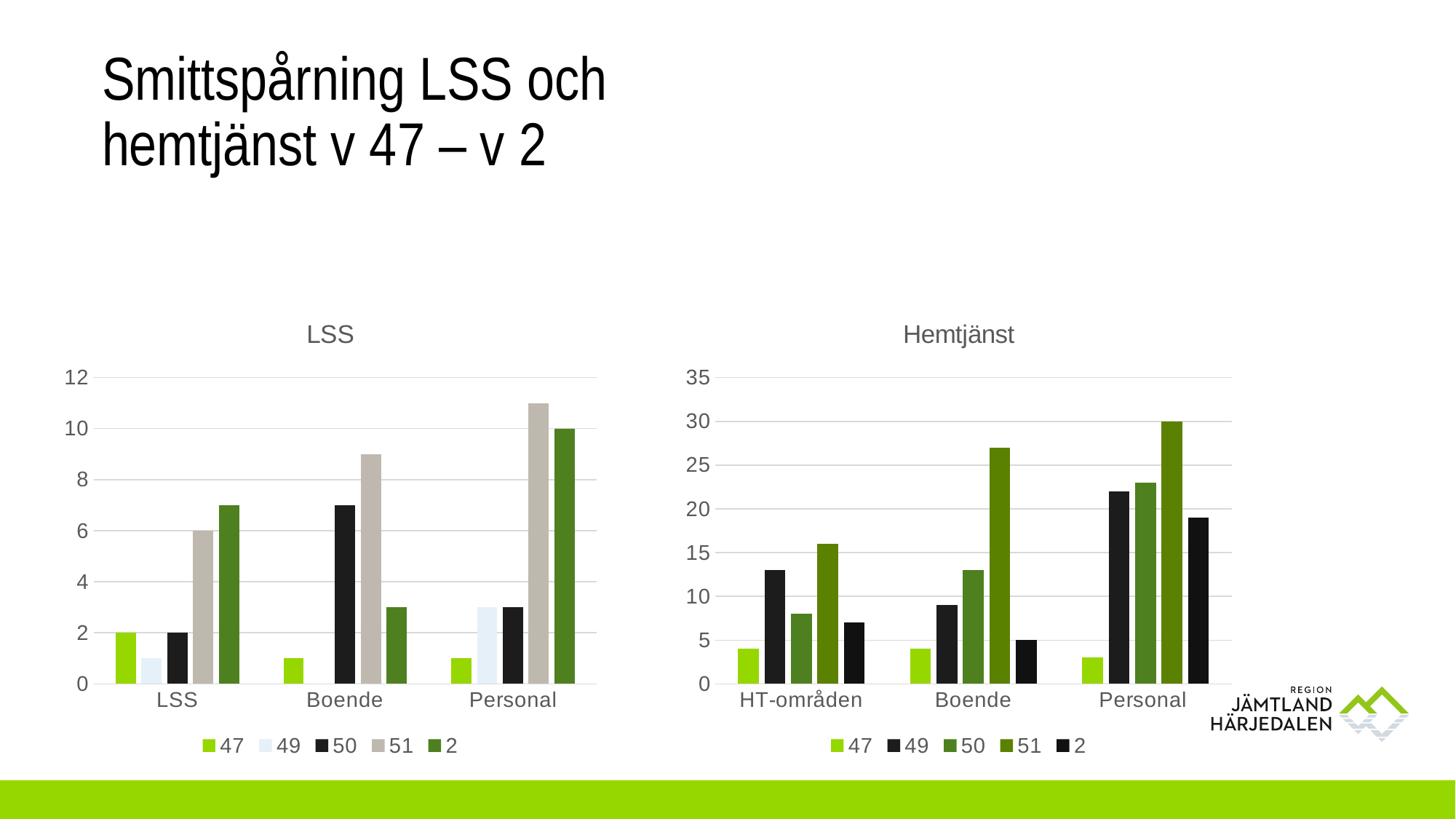
In the Hemtjänst chart, do the values for series 51 rise or fall from HT-områden to Personal? rise In the Hemtjänst chart, what is the value for series 51 in the Personal category? 30 In the Hemtjänst chart, what is the value for series 2 in the Boende category? 5 How many series does the legend of the Hemtjänst chart list? 5 In the LSS chart, which series has the highest bar in the Personal category? 51 In the Hemtjänst chart, which category and series has the highest bar? Personal, series 51 In the LSS chart, what is the value for series 51 in the LSS category? 6 In the LSS chart, in the Boende category, which is larger: series 51 or series 2? 51 In the LSS chart, is the value for series 51 in the Personal category greater or less than 10? greater In the LSS chart, what is the value for series 2 in the Personal category? 10 In the Hemtjänst chart, is the value for series 51 in the Boende category greater or less than 25? greater In the LSS chart, what is the value for series 47 in the LSS category? 2